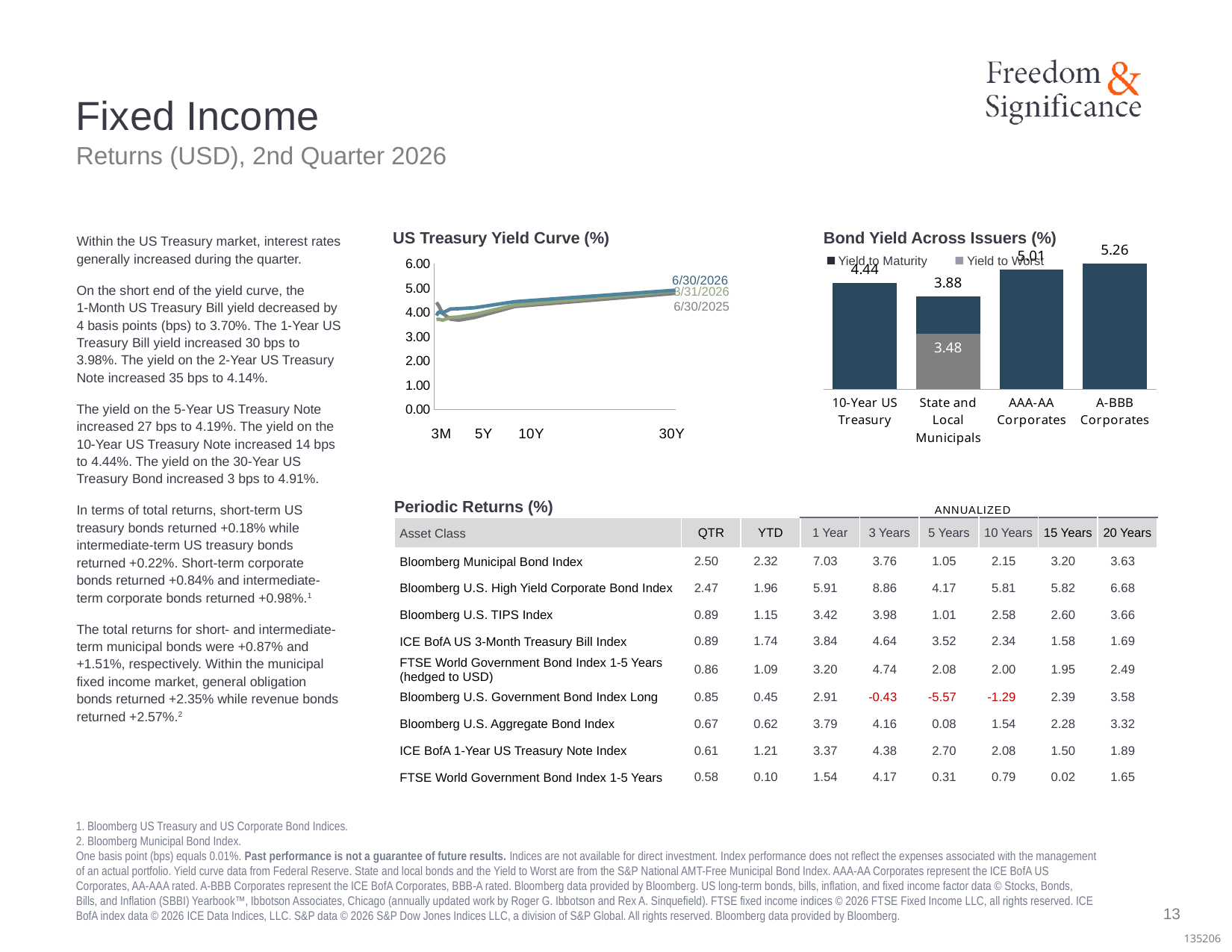
What type of chart is the US Treasury Yield Curve (%) chart? Line chart In the Bond Yield Across Issuers (%) chart, what is the yield to maturity for 10-Year US Treasury? 4.44 In the Bond Yield Across Issuers (%) chart, which issuer category has the highest yield to maturity? A-BBB Corporates How many series does the US Treasury Yield Curve (%) chart show? 3 In the Bond Yield Across Issuers (%) chart, what is the difference between the yield to maturity of A-BBB Corporates and AAA-AA Corporates? 0.25 In the Bond Yield Across Issuers (%) chart, what is the yield to maturity for A-BBB Corporates? 5.26 In the US Treasury Yield Curve (%) chart, is the 6/30/2026 value at 30Y greater or less than 4.00? greater How many series does the legend of the Bond Yield Across Issuers (%) chart list? 2 In the Bond Yield Across Issuers (%) chart, which is larger: the yield to maturity for 10-Year US Treasury or for AAA-AA Corporates? AAA-AA Corporates In the Bond Yield Across Issuers (%) chart, which issuer category has the lowest yield to maturity? State and Local Municipals How many issuer categories are shown in the Bond Yield Across Issuers (%) chart? 4 In the Bond Yield Across Issuers (%) chart, what is the Yield to Worst value shown for State and Local Municipals? 3.48